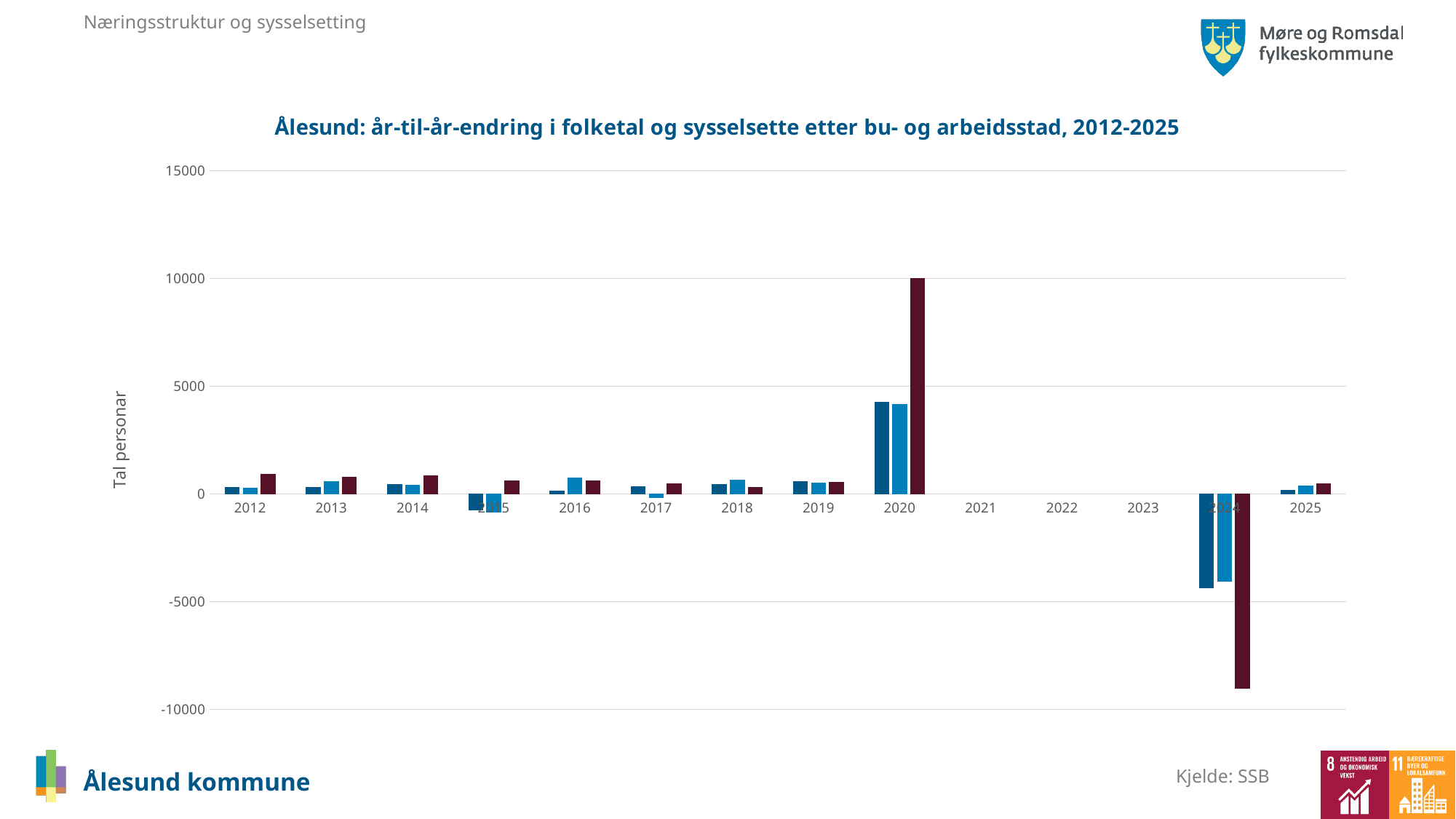
Is the dark red bar for 2024 greater or less than -5000? less Is the dark blue bar for 2020 greater or less than 5000? less Is the dark blue bar for 2024 greater or less than -5000? greater How many years are labelled along the x axis of the chart? 14 In which year does the chart show the lowest (most negative) bar? 2024 What is the title of the chart? Ålesund: år-til-år-endring i folketal og sysselsette etter bu- og arbeidsstad, 2012-2025 What is the label on the y axis of the chart? Tal personar Which year has the larger dark red bar, 2012 or 2020? 2020 How many years on the x axis show no visible bars at all? 3 In which year does the chart show the tallest positive bar? 2020 What kind of chart is shown on the slide? bar chart